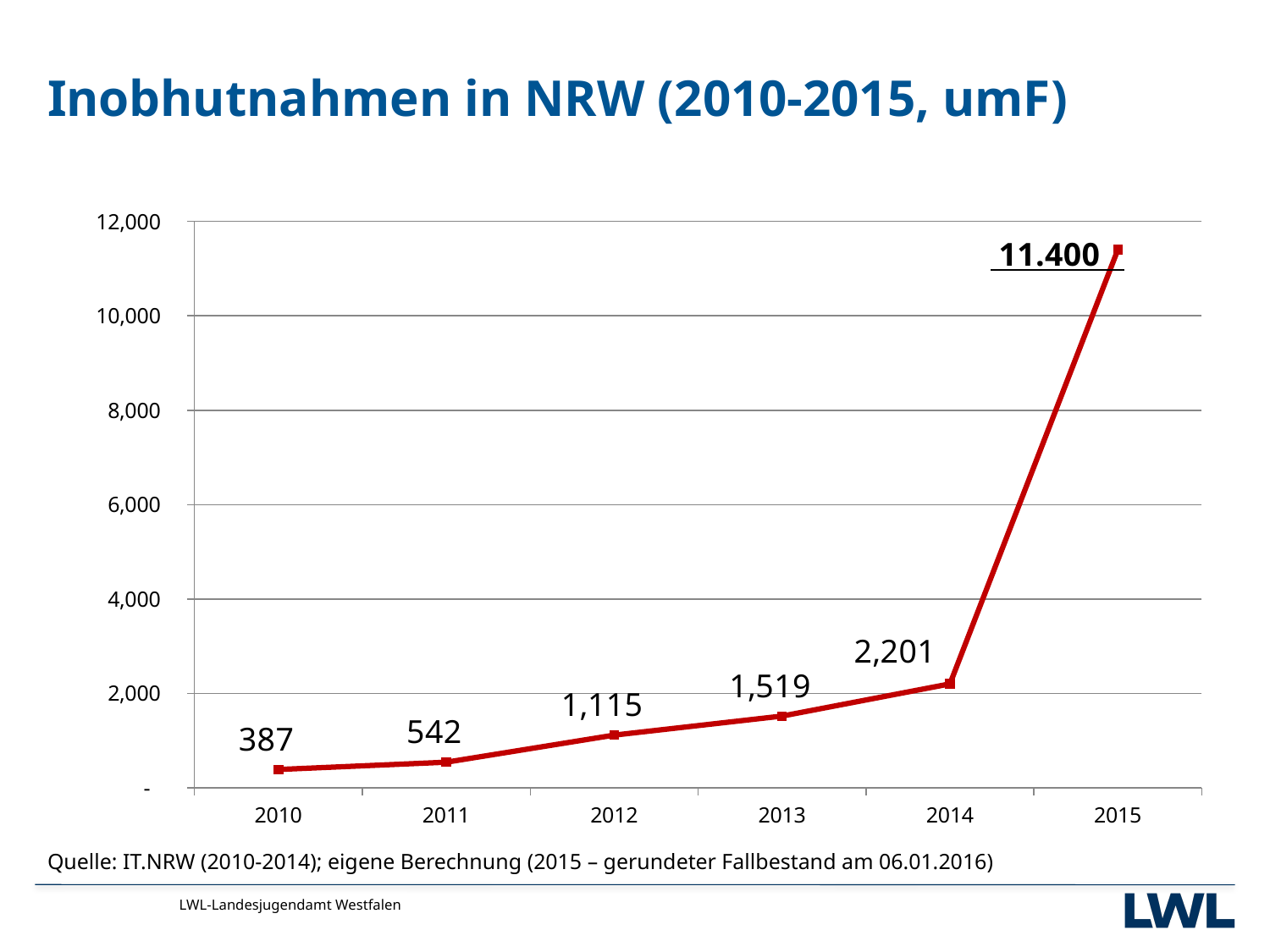
Which year has the highest value? 2015 Which is larger, the value for 2012 or the value for 2011? 2012 What is the difference between the values for 2014 and 2013? 682 What kind of chart is shown on the slide? line chart What is the value for 2013? 1,519 Do the values rise or fall from 2010 to 2015? rise Which year has the lowest value? 2010 Is the value for 2014 greater or less than 4,000? less What is the value for 2015? 11.400 What is the value for 2010? 387 How many years are plotted on the chart? 6 What is the difference between the values for 2012 and 2011? 573